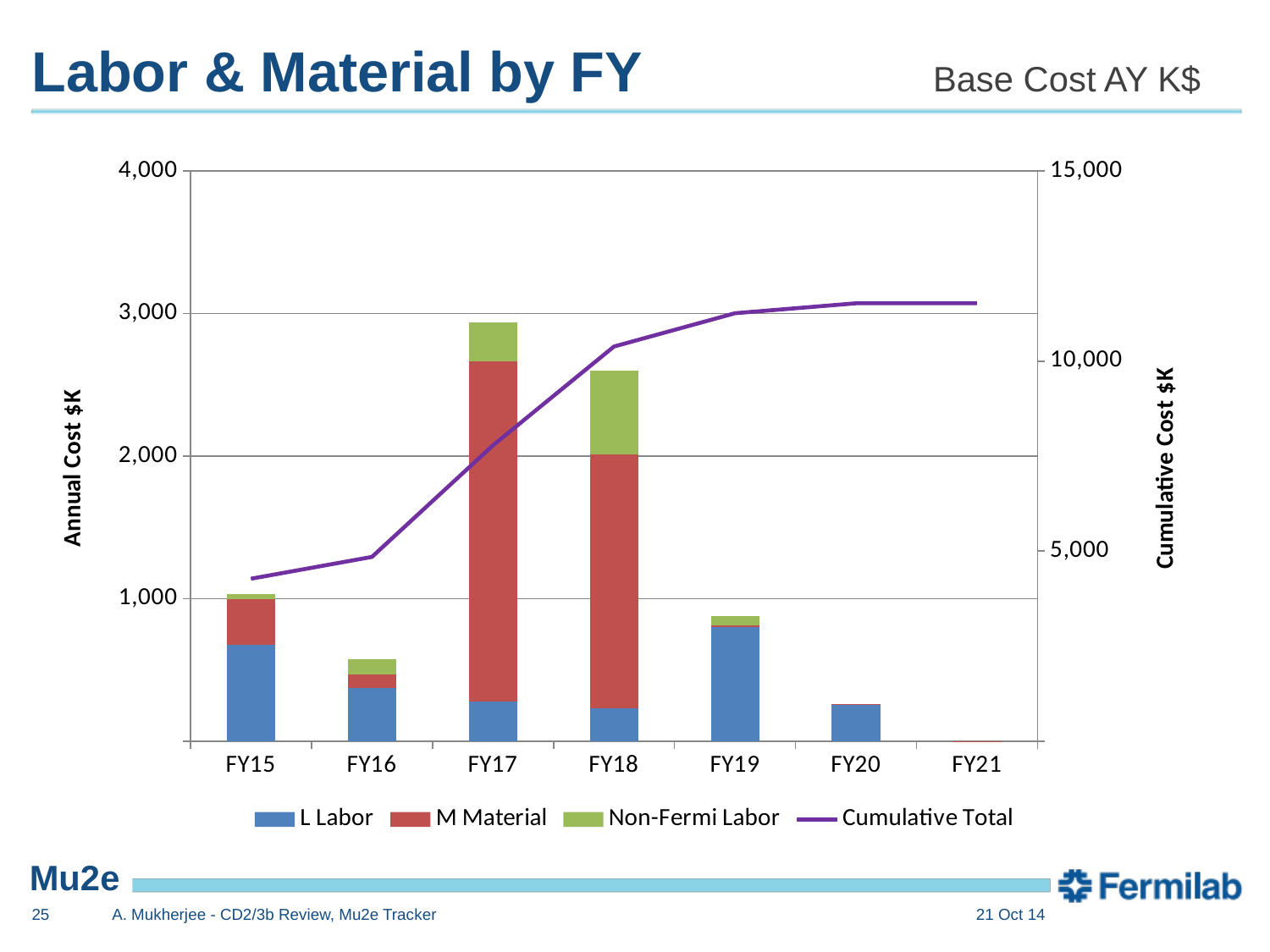
What kind of chart is shown on the slide? A stacked bar chart with a line Does the Cumulative Total line rise or fall from FY15 to FY21? rise What is the title of the right-hand vertical axis? Cumulative Cost $K Is the Cumulative Total for FY20 greater or less than 10,000? greater Is the Cumulative Total for FY17 greater or less than 10,000? less Which fiscal year has the lowest total annual cost bar? FY21 Is the total annual cost for FY16 greater or less than 1,000? less Which has the larger total annual cost bar, FY15 or FY16? FY15 Which fiscal year has the highest total annual cost bar? FY17 How many fiscal years are shown on the x axis? 7 How many series does the legend list? 4